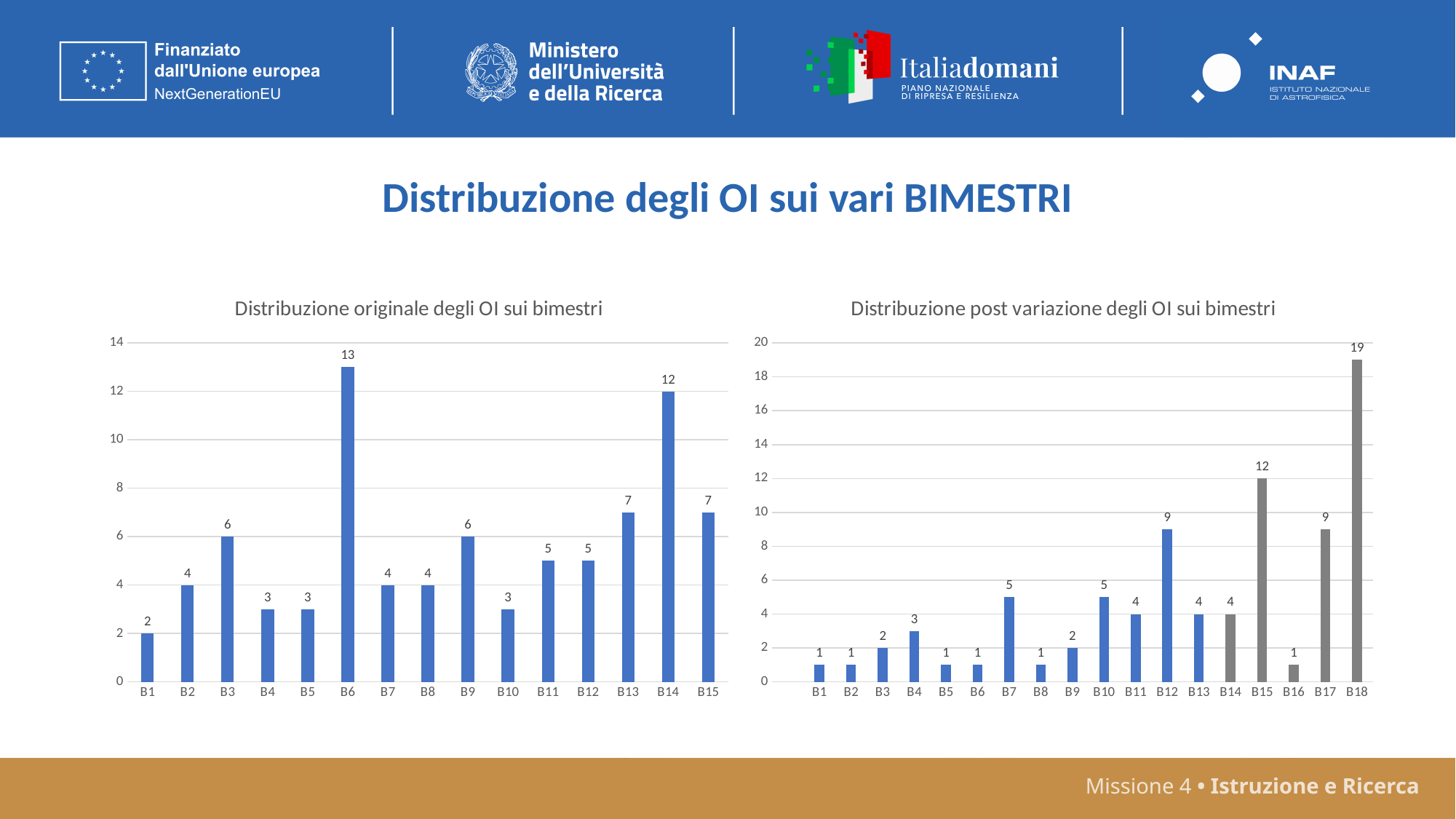
In the chart 'Distribuzione post variazione degli OI sui bimestri', which is larger, the value for B12 or the value for B17? Neither; they are equal (both 9) In the chart 'Distribuzione originale degli OI sui bimestri', which category has the lowest value? B1 In the chart 'Distribuzione originale degli OI sui bimestri', what is the difference between the values for B14 and B13? 5 In the chart 'Distribuzione originale degli OI sui bimestri', what is the value for B6? 13 In the chart 'Distribuzione originale degli OI sui bimestri', which category has the highest value? B6 In the chart 'Distribuzione post variazione degli OI sui bimestri', what is the difference between the values for B18 and B15? 7 In the chart 'Distribuzione post variazione degli OI sui bimestri', which category has the highest value? B18 In the chart 'Distribuzione originale degli OI sui bimestri', how many categories are shown on the x axis? 15 What kind of chart is 'Distribuzione post variazione degli OI sui bimestri'? Bar chart In the chart 'Distribuzione post variazione degli OI sui bimestri', how many categories are shown on the x axis? 18 In the chart 'Distribuzione post variazione degli OI sui bimestri', what is the value for B18? 19 In the chart 'Distribuzione post variazione degli OI sui bimestri', what is the value for B15? 12